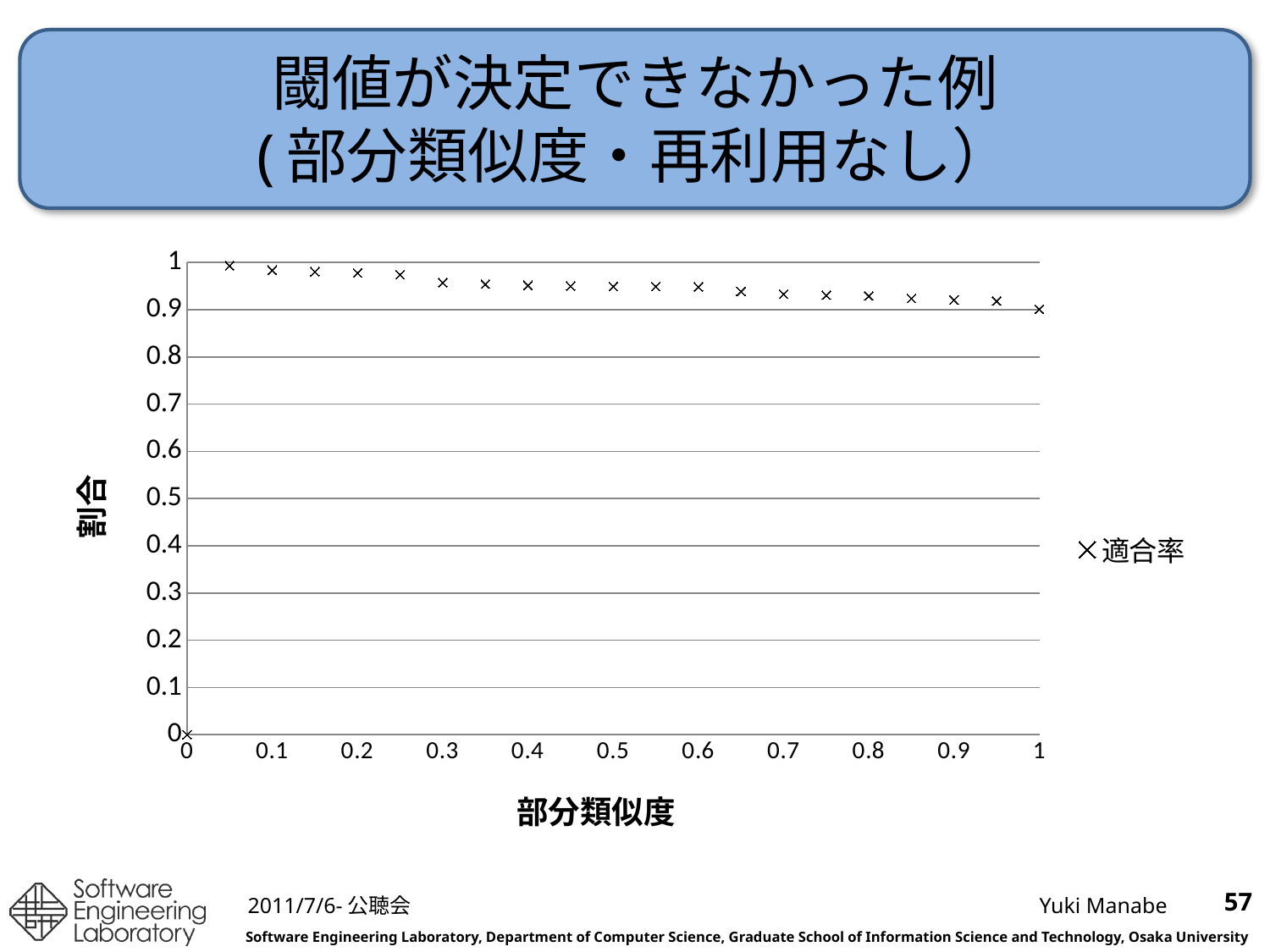
Is the value of 適合率 at 部分類似度 = 0.5 greater or less than 0.9? greater What is the value of 適合率 at 部分類似度 = 0? 0 What is the name of the series shown in the legend? 適合率 How many series does the legend list? 1 At which 部分類似度 value is 適合率 lowest? 0 Excluding the point at 0, do the 適合率 values rise or fall as 部分類似度 increases? fall What kind of chart is shown on the slide? scatter chart Is the value of 適合率 at 部分類似度 = 0.2 greater or less than 0.9? greater What is the title of the x axis? 部分類似度 Is the value of 適合率 at 部分類似度 = 0.8 greater or less than 0.8? greater How many data points are plotted for 適合率? 21 Which is larger, the 適合率 at 部分類似度 = 0.1 or at 部分類似度 = 0.9? 0.1